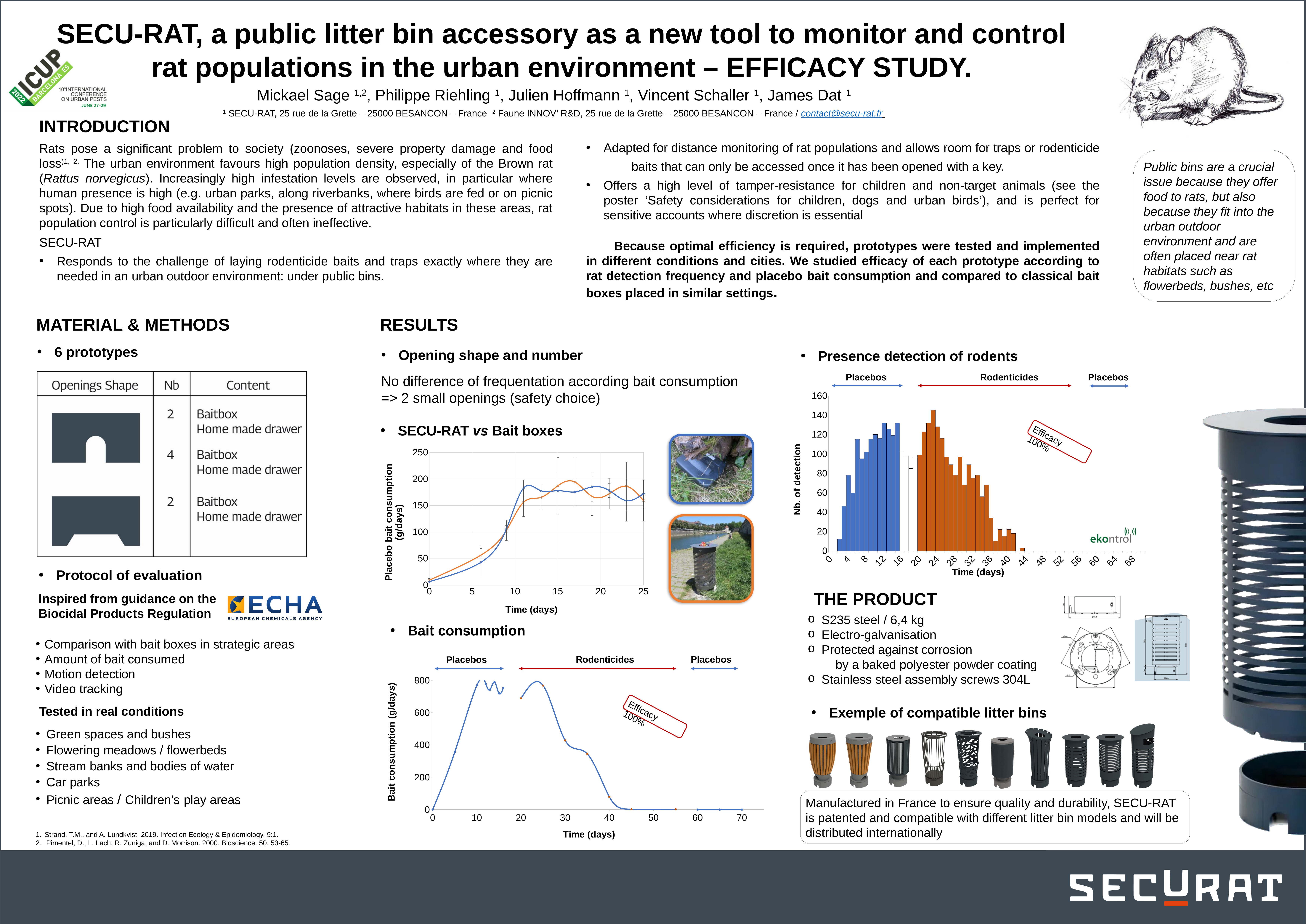
What kind of chart is the "Presence detection of rodents" chart? bar chart What kind of chart is the "Bait consumption" chart? line chart In the "SECU-RAT vs Bait boxes" chart, how many lines are plotted? 2 In the "Bait consumption" chart, is the value at day 50 greater or less than 200? less What kind of chart is the "SECU-RAT vs Bait boxes" chart? line chart In the "Presence detection of rodents" chart, is the tallest bar greater or less than 120? greater In the "Bait consumption" chart, do the values rise or fall between day 30 and day 45? fall In the "Presence detection of rodents" chart, what is the label of the vertical axis? Nb. of detection In the "Bait consumption" chart, is the value at day 10 greater or less than 600? greater In the "SECU-RAT vs Bait boxes" chart, do the values rise or fall between day 0 and day 10? rise In the "Bait consumption" chart, what is the label of the horizontal axis? Time (days)